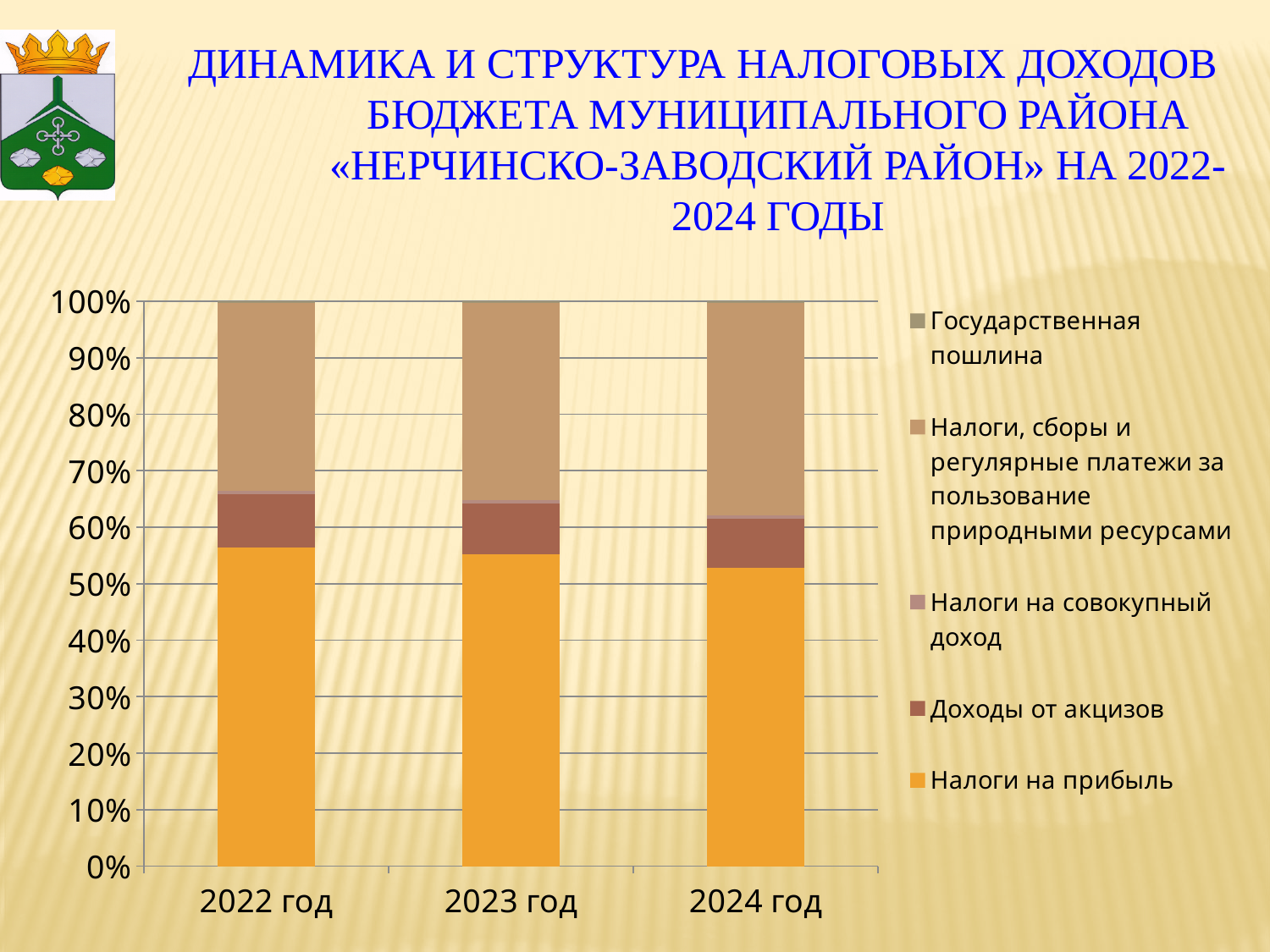
Does the share of Налоги на прибыль rise or fall from 2022 год to 2024 год? fall Is the share of Налоги на прибыль in 2023 год greater or less than 60%? less What is the total height of each stacked bar on the percentage axis? 100% Does the share of Налоги, сборы и регулярные платежи за пользование природными ресурсами rise or fall from 2022 год to 2024 год? rise Which year has the larger share of Налоги на прибыль, 2022 год or 2024 год? 2022 год Is the share of Налоги на прибыль in 2024 год greater or less than 60%? less Which series is shown at the bottom of each stacked bar? Налоги на прибыль Is the share of Налоги на прибыль in 2022 год greater or less than 50%? greater What kind of chart is shown on the slide? stacked bar chart How many years (categories) are shown on the x axis of the chart? 3 How many series does the chart legend list? 5